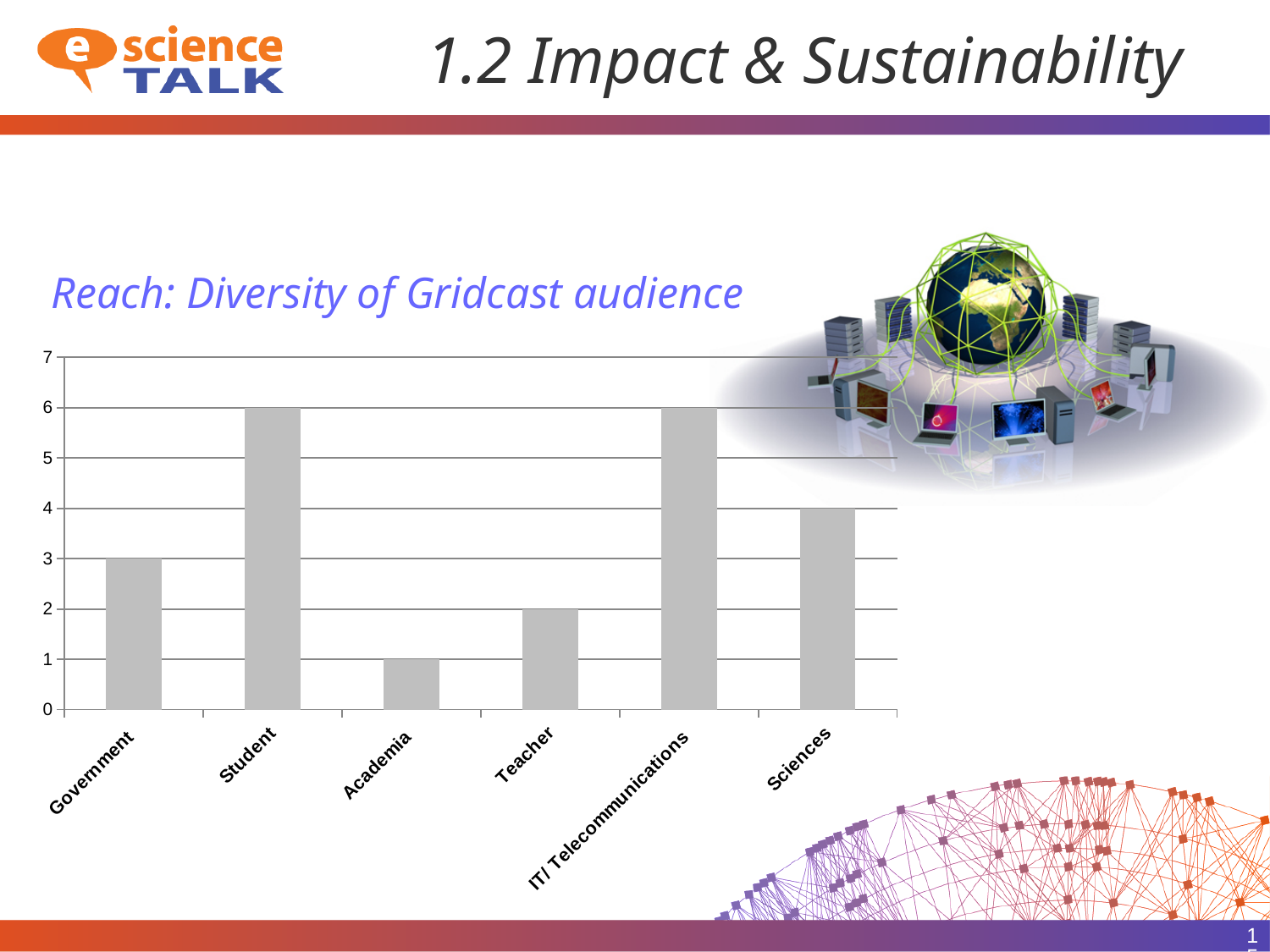
What is the highest value shown on the y axis? 7 What is the title of the chart? Reach: Diversity of Gridcast audience Which category has the lowest value? Academia How many categories are shown on the x axis of the chart? 6 Which is larger, the value for Sciences or the value for Government? Sciences What is the value for Sciences? 4 What is the value for Academia? 1 What is the difference between the values for Student and Teacher? 4 What type of chart is shown on the slide? bar chart What is the value for Student? 6 Is the value for IT/ Telecommunications greater or less than 5? greater What is the value for Government? 3